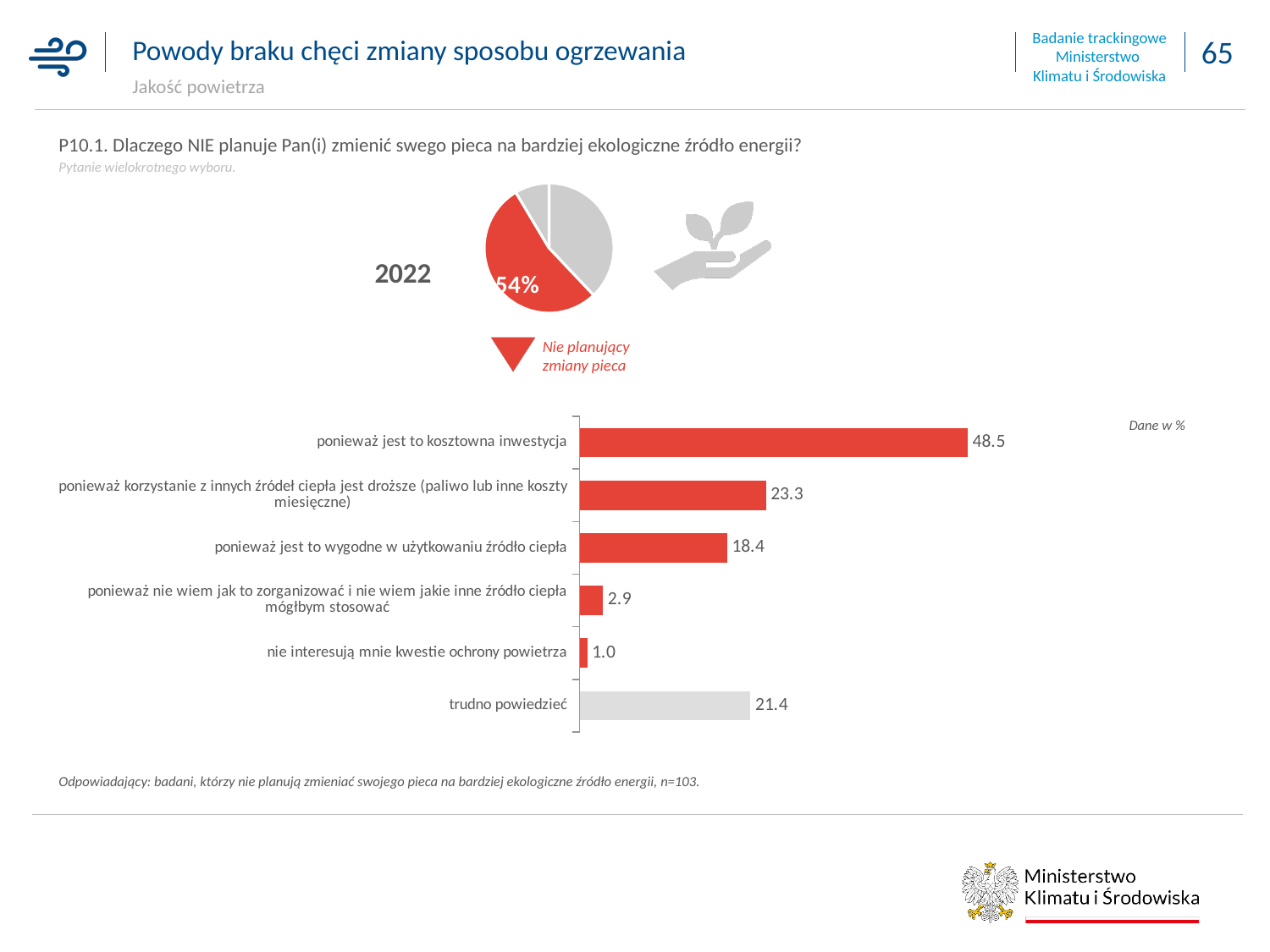
How many categories are shown in the bar chart at the bottom? 6 In the bar chart at the bottom, what is the value for "trudno powiedzieć"? 21.4 In the bar chart at the bottom, which category has the lowest value? nie interesują mnie kwestie ochrony powietrza In the bar chart at the bottom, which bar is coloured grey rather than red? trudno powiedzieć In the bar chart at the bottom, what is the value for "ponieważ jest to wygodne w użytkowaniu źródło ciepła"? 18.4 What kind of chart is shown at the top of the slide next to the label 2022? pie chart In the bar chart at the bottom, which is larger: the value for "trudno powiedzieć" or the value for "ponieważ jest to wygodne w użytkowaniu źródło ciepła"? trudno powiedzieć What kind of chart is shown at the bottom of the slide? bar chart In the bar chart at the bottom, what is the value for "ponieważ jest to kosztowna inwestycja"? 48.5 In the bar chart at the bottom, which category has the highest value? ponieważ jest to kosztowna inwestycja In the pie chart at the top, what share is labelled for "Nie planujący zmiany pieca"? 54% In the bar chart at the bottom, what is the difference between the values for "ponieważ jest to kosztowna inwestycja" and "ponieważ korzystanie z innych źródeł ciepła jest droższe (paliwo lub inne koszty miesięczne)"? 25.2